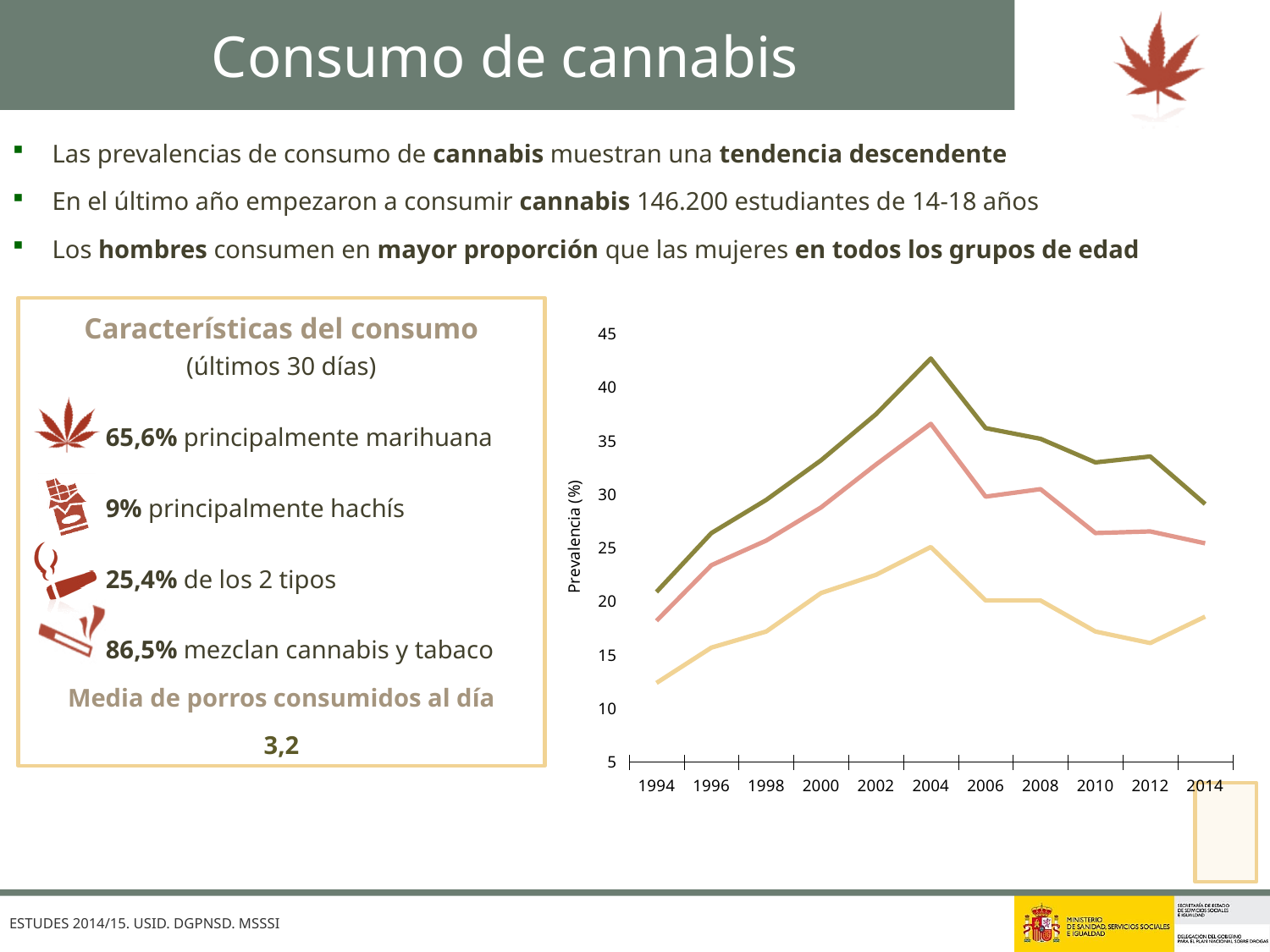
In 2014, which line has the higher value, the dark green line or the light yellow line? the dark green line Is the value of the light yellow line in 1994 greater or less than 15? less Is the value of the salmon line in 2004 greater or less than 35? greater Do the values of the dark green line rise or fall between 2004 and 2014? fall Is the value of the light yellow line in 2012 greater or less than 20? less How many years are labelled on the x axis of the chart? 11 How many lines are plotted on the chart? 3 What kind of chart is shown on the right of the slide? line chart In which year does the light yellow line reach its lowest value? 1994 What is the label of the y axis of the chart? Prevalencia (%) In which year does the dark green line reach its highest value? 2004